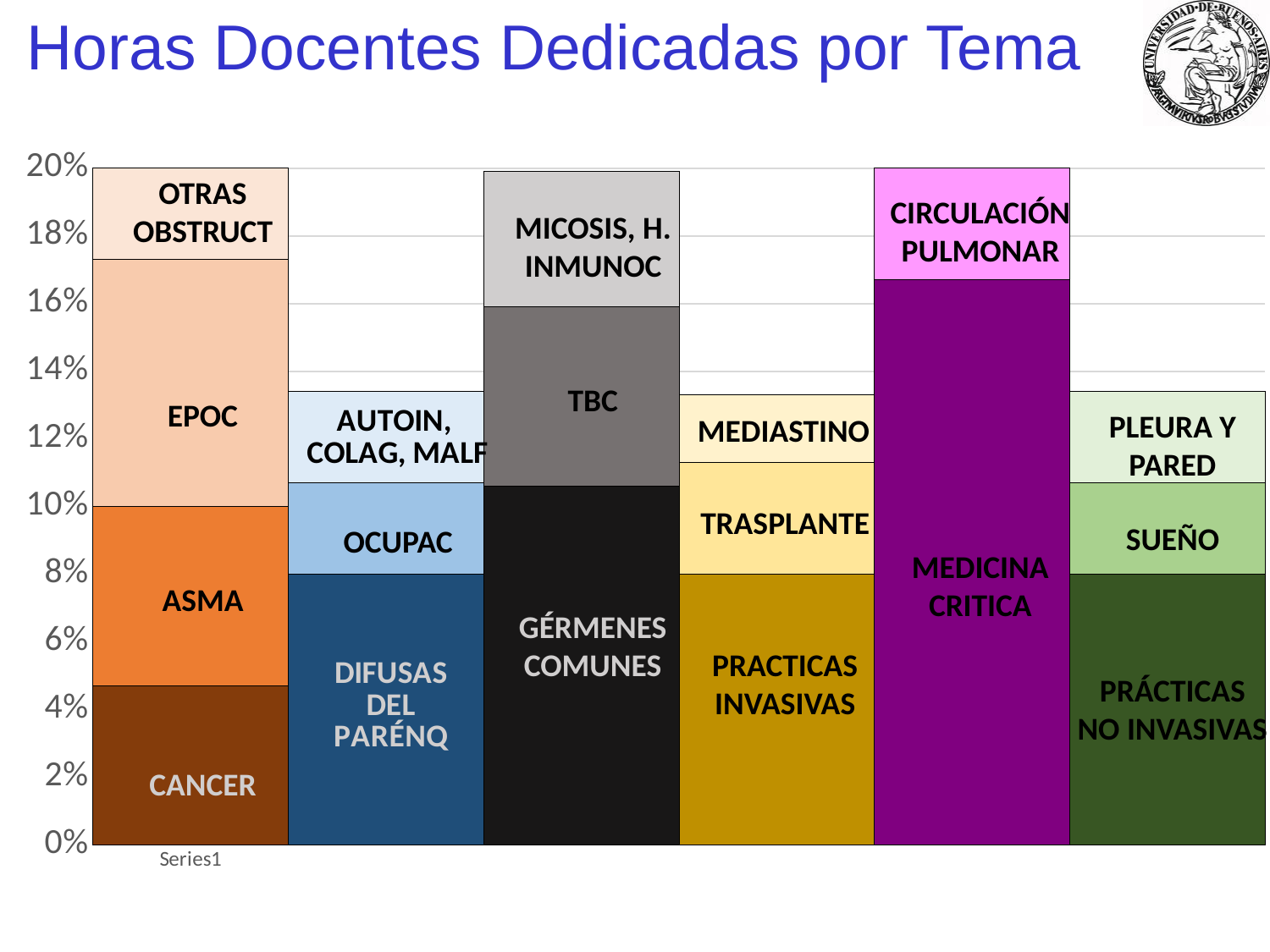
What kind of chart is shown on the slide? stacked bar chart Is the value for MEDIASTINO greater or less than 4%? less How many stacked bars are plotted in the chart? 6 Is the value for MEDICINA CRITICA greater or less than 10%? greater What is the total height of the stacked bar that contains MEDICINA CRITICA and CIRCULACIÓN PULMONAR? 20% Which segment in the chart is the largest? MEDICINA CRITICA Is the value for TBC greater or less than 4%? greater What is the title of the chart on the slide? Horas Docentes Dedicadas por Tema Which is larger, EPOC or ASMA? EPOC Which is larger, GÉRMENES COMUNES or TBC? GÉRMENES COMUNES What label appears under the x axis of the chart? Series1